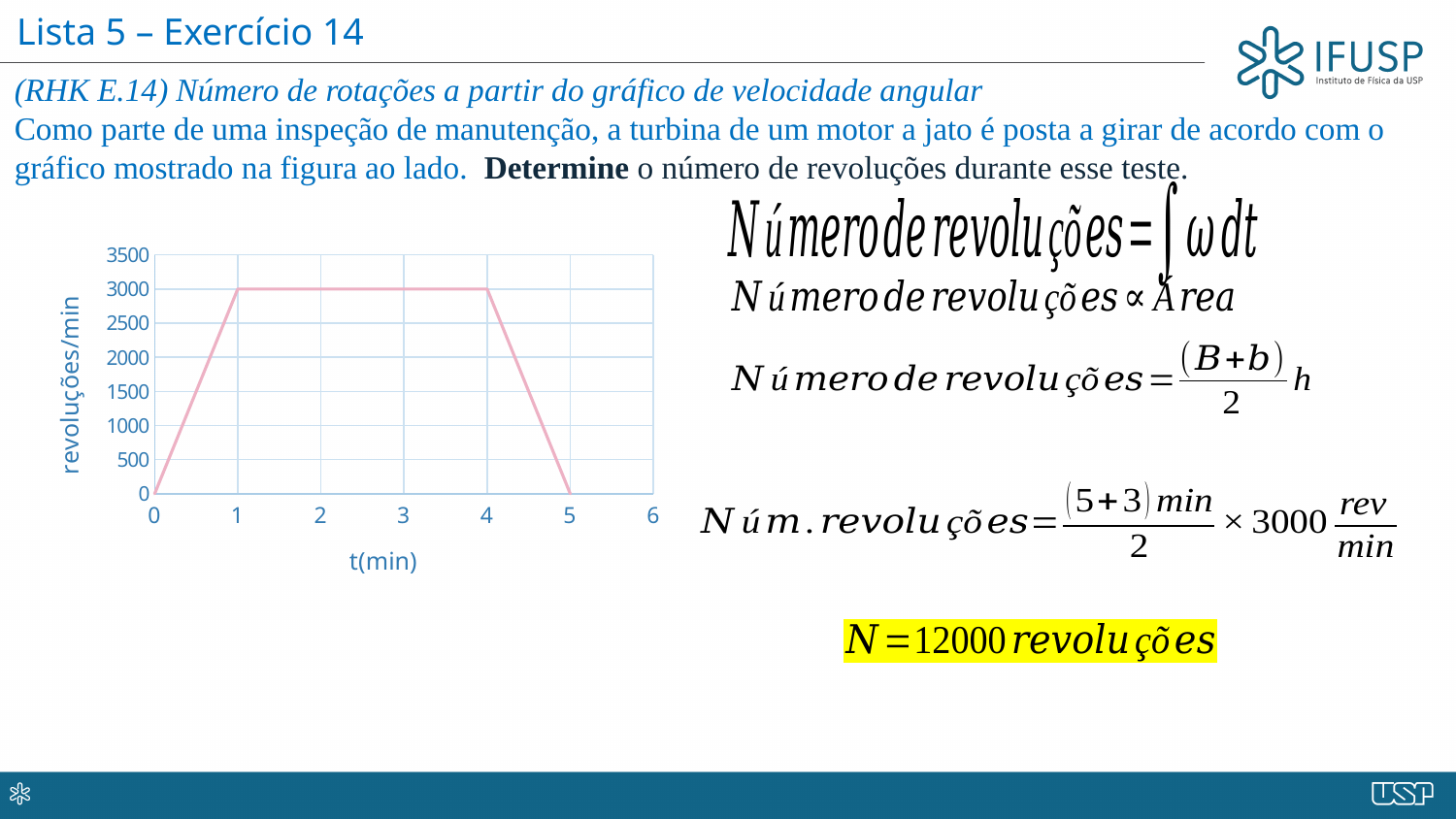
Is the value at t = 2 min greater or less than 2500? greater Which is larger: the value at t = 3 min or the value at t = 0.5 min? t = 3 min What is the value in revoluções/min at t = 1 min? 3000 What is the value in revoluções/min at t = 5 min? 0 What kind of chart is shown on the slide? line chart What is the value in revoluções/min at t = 4 min? 3000 Between t = 4 and t = 5 min, does the value rise or fall? fall What is the label of the vertical axis? revoluções/min What is the value in revoluções/min at t = 0 min? 0 What is the label of the horizontal axis? t(min) What is the maximum value reached on the chart, in revoluções/min? 3000 Between t = 0 and t = 1 min, does the value rise or fall? rise